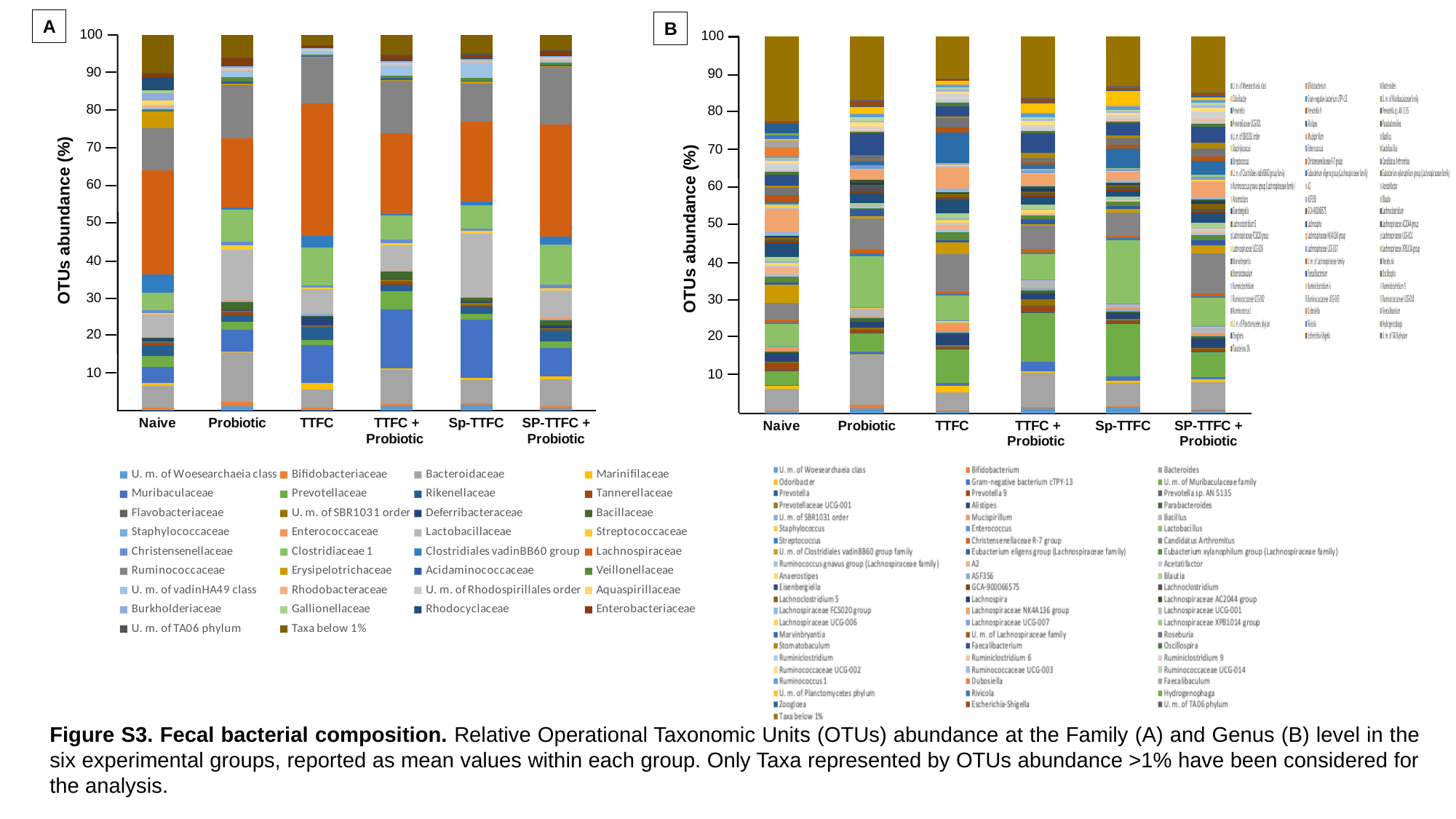
In chart B, which group has the largest 'Taxa below 1%' (top dark brown) segment? Naive How many experimental groups are shown along the x axis of chart A? 6 How many experimental groups are shown along the x axis of chart B? 6 How many taxa does the legend of chart A list? 34 In chart A, which group has the largest 'Taxa below 1%' (top dark brown) segment? Naive What is the y-axis label of chart A? OTUs abundance (%) Which taxonomic level does chart B show, according to the caption? Genus What is the total height of the stacked bar for Naive in chart A? 100 What kind of chart is chart A? stacked bar chart